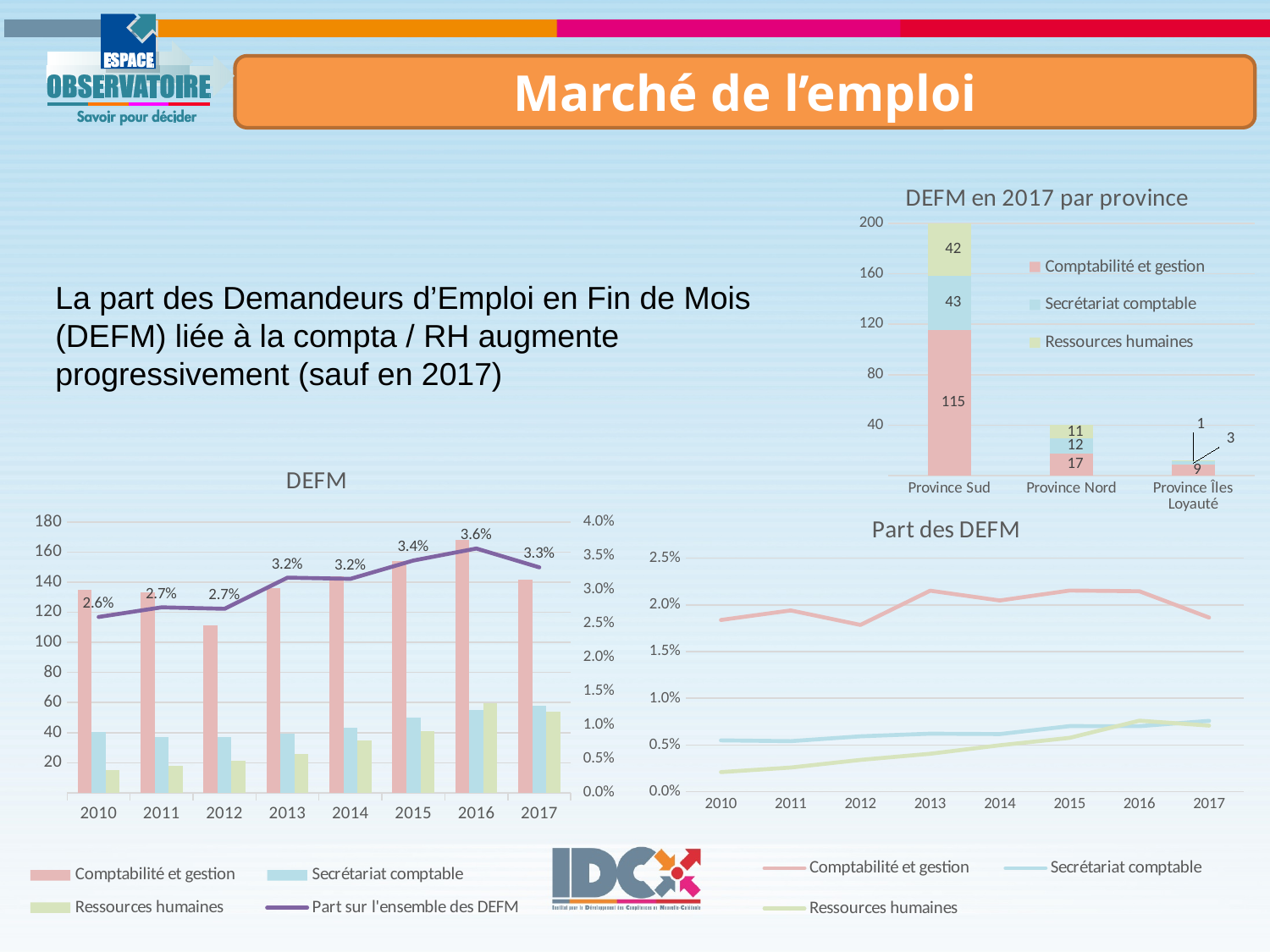
In the 'DEFM en 2017 par province' chart, what is the value of 'Secrétariat comptable' for Province Sud? 43 In the 'DEFM en 2017 par province' chart, which province has the highest total? Province Sud In the DEFM chart, in which year is 'Part sur l'ensemble des DEFM' lowest? 2010 In the DEFM chart, what is the difference between the 'Part sur l'ensemble des DEFM' values for 2016 and 2017? 0.3% In the 'Part des DEFM' chart, is the 'Comptabilité et gestion' value for 2013 greater or less than 2.0%? greater In the 'DEFM en 2017 par province' chart, what is the total of the stacked bar for Province Nord? 40 In the DEFM chart, how many years are shown on the x axis? 8 In the 'DEFM en 2017 par province' chart, which is larger: 'Comptabilité et gestion' for Province Nord or for Province Îles Loyauté? Province Nord In the DEFM chart, how many series does the legend list? 4 In the DEFM chart, what is the value of 'Part sur l'ensemble des DEFM' in 2016? 3.6% In the DEFM chart, is the 'Comptabilité et gestion' bar for 2012 greater or less than 120? less In the 'Part des DEFM' chart, does the 'Ressources humaines' line rise or fall from 2010 to 2017? rise